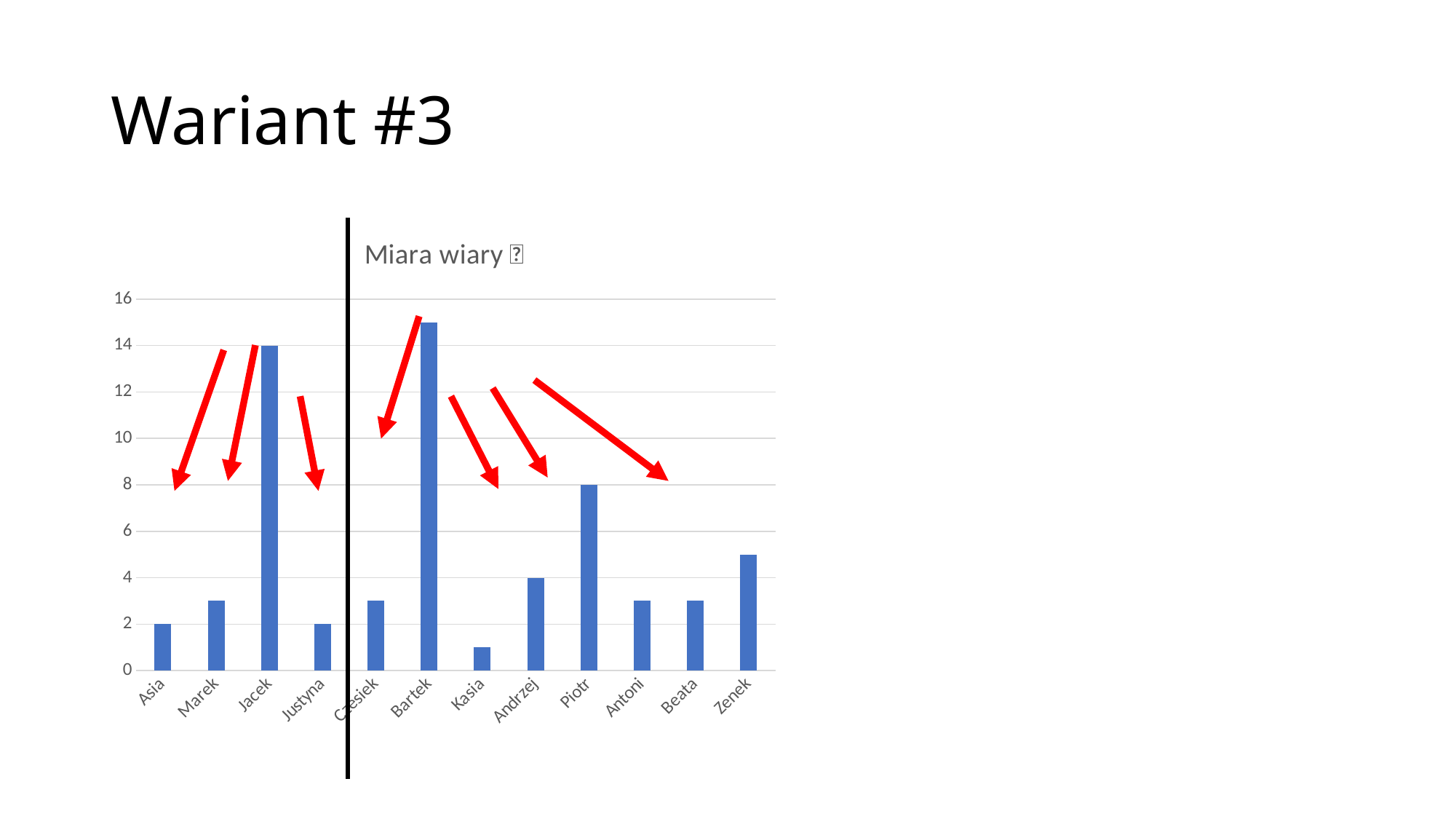
Which category has the highest bar in the chart? Bartek Is the value for Kasia greater or less than 2? less What is the value for Piotr? 8 Which category has the lowest bar in the chart? Kasia What is the value for Jacek? 14 What is the value for Andrzej? 4 What kind of chart is shown on the slide? bar chart Which is larger, the value for Piotr or the value for Andrzej? Piotr What is the difference between the values for Jacek and Asia? 12 Is the value for Bartek greater or less than 14? greater What is the title of the chart? Miara wiary How many categories (names) are shown on the x axis of the chart? 12